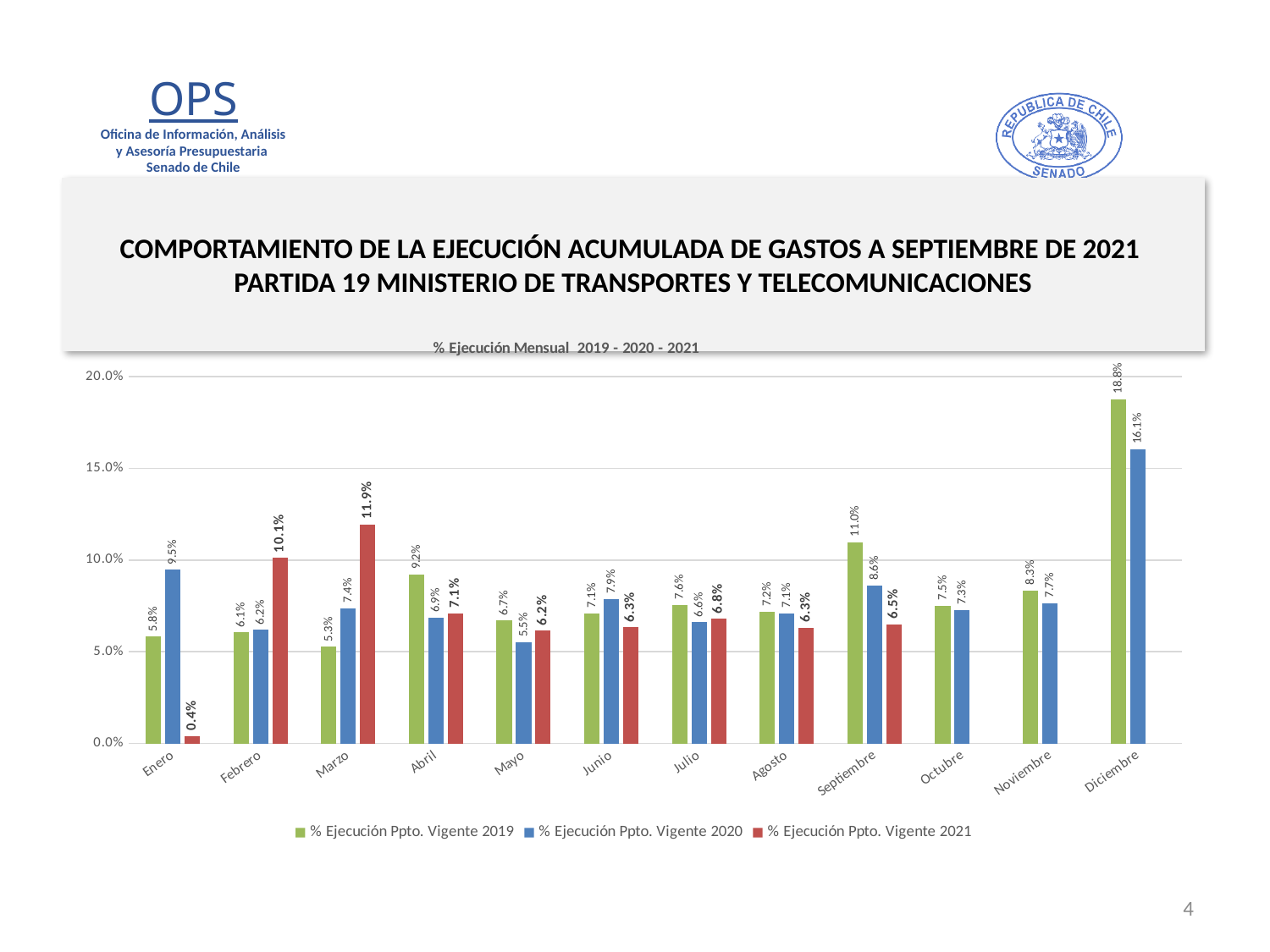
What is the value for % Ejecución Ppto. Vigente 2021 in Enero? 0.4% How many series does the legend list? 3 Which is larger in Abril: the 2019 value or the 2020 value? 2019 (9.2%) In which month is the % Ejecución Ppto. Vigente 2020 series lowest? Mayo How many months are shown on the x axis? 12 What is the title of the chart? % Ejecución Mensual 2019 - 2020 - 2021 In which month is the % Ejecución Ppto. Vigente 2021 series highest? Marzo What is the value for % Ejecución Ppto. Vigente 2019 in Diciembre? 18.8% What kind of chart is shown on the slide? Bar chart What is the value for % Ejecución Ppto. Vigente 2020 in Septiembre? 8.6% Is the value for % Ejecución Ppto. Vigente 2019 in Septiembre greater or less than 10.0%? greater What is the difference between the 2019 and 2020 values in Diciembre? 2.7%